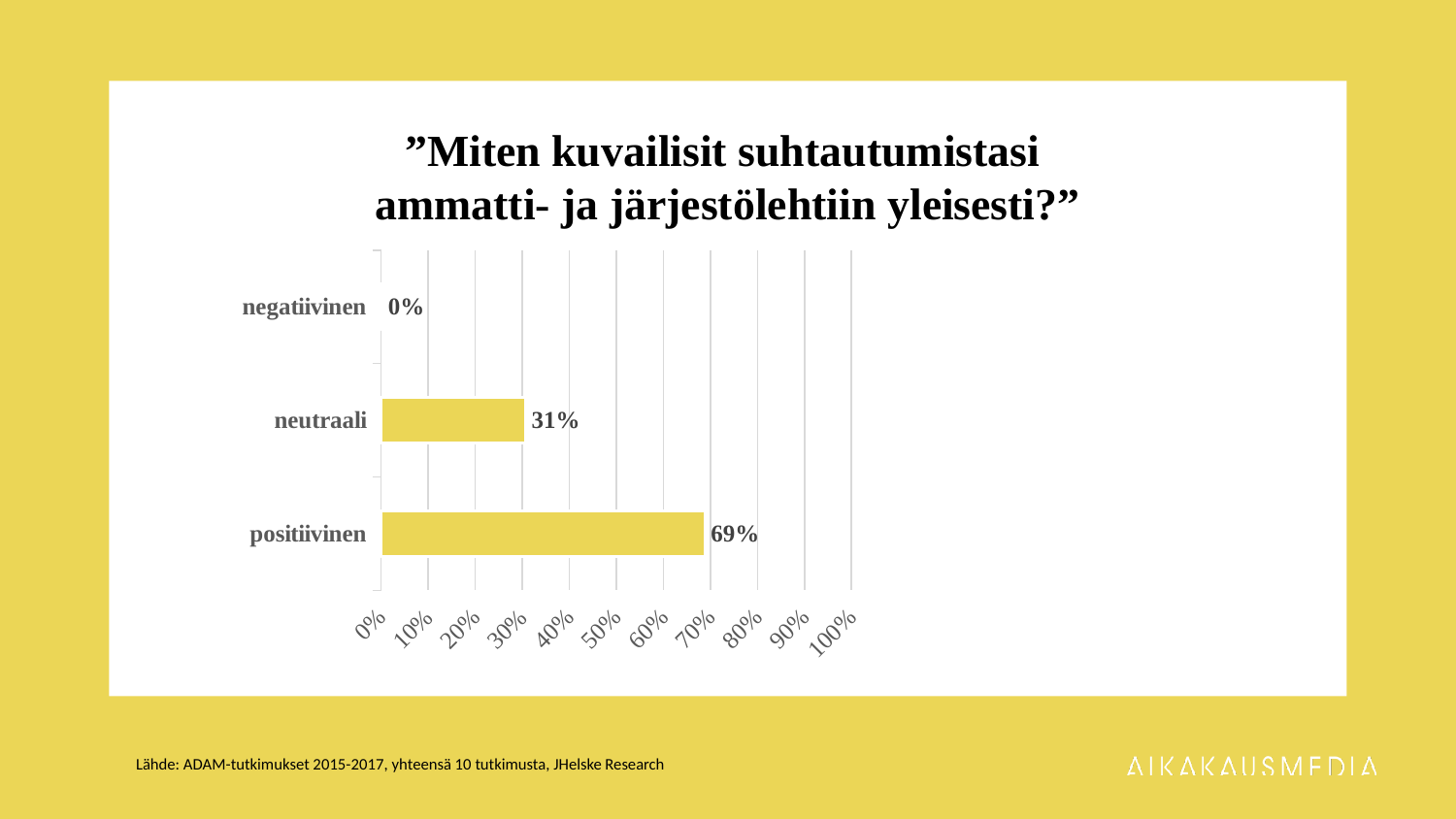
What is the difference between the values for "positiivinen" and "neutraali"? 38% Is the value for "positiivinen" greater or less than 60%? greater What is the value for "positiivinen"? 69% What is the value for "negatiivinen"? 0% Which is larger, the value for "neutraali" or the value for "positiivinen"? positiivinen Which category has the highest value? positiivinen Is the value for "neutraali" greater or less than 40%? less What is the value for "neutraali"? 31% How many categories are shown in the chart? 3 What kind of chart is shown on the slide? bar chart Which category has the lowest value? negatiivinen What is the highest tick value shown on the horizontal axis? 100%